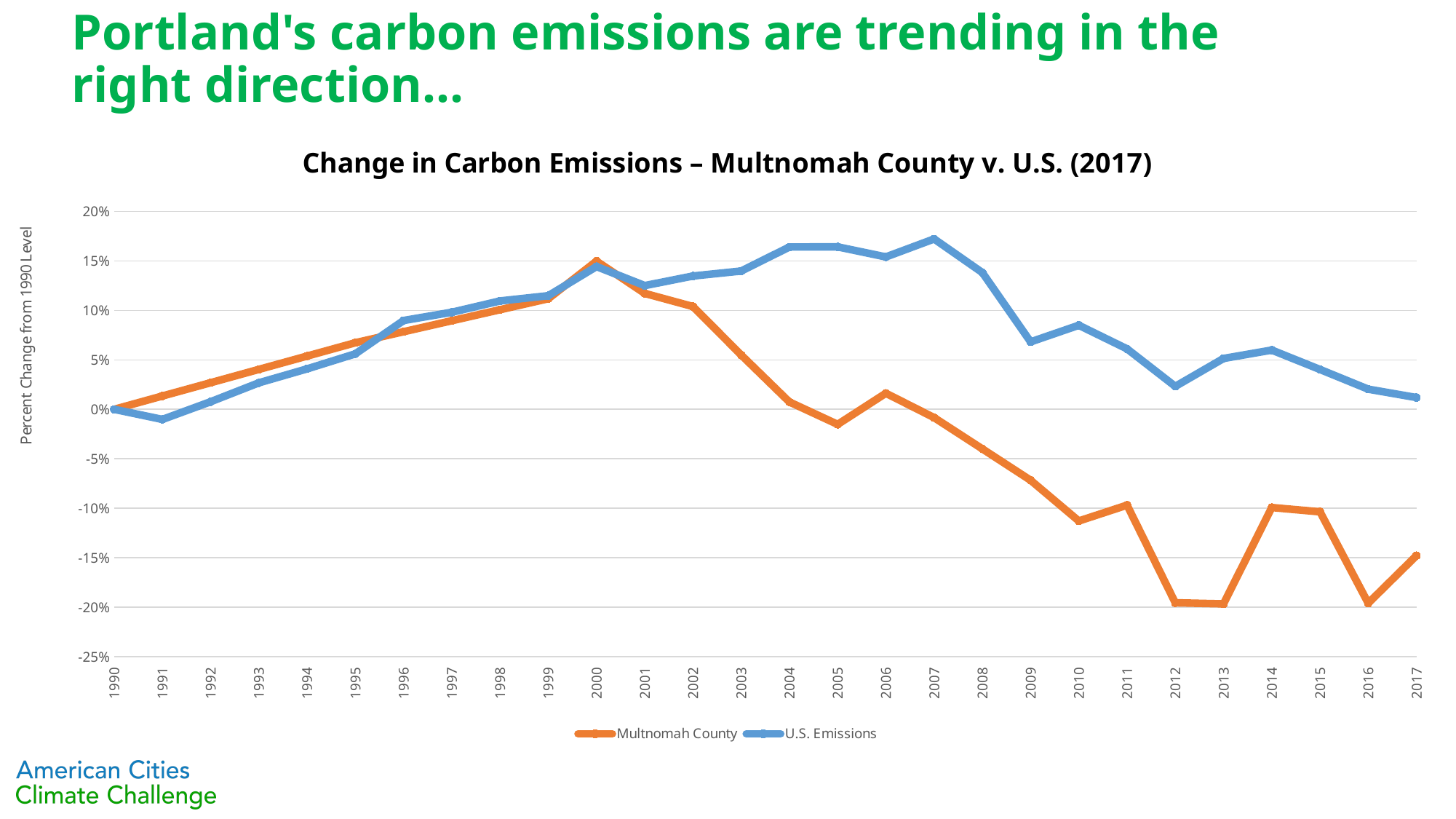
What is the label on the vertical axis? Percent Change from 1990 Level How many series does the legend list? 2 In which year does the Multnomah County series reach its highest value? 2000 How many years are plotted along the x axis? 28 What is the title of the chart? Change in Carbon Emissions – Multnomah County v. U.S. (2017) Is the value for Multnomah County in 2012 greater or less than -15%? less In 2010, which series has the higher value, Multnomah County or U.S. Emissions? U.S. Emissions What kind of chart is shown on the slide? Line chart Is the value for U.S. Emissions in 2007 greater or less than 15%? greater Is the value for U.S. Emissions in 2017 greater or less than 5%? less Does the Multnomah County series rise or fall between 2000 and 2012? Fall In which year does the U.S. Emissions series reach its lowest value? 1991